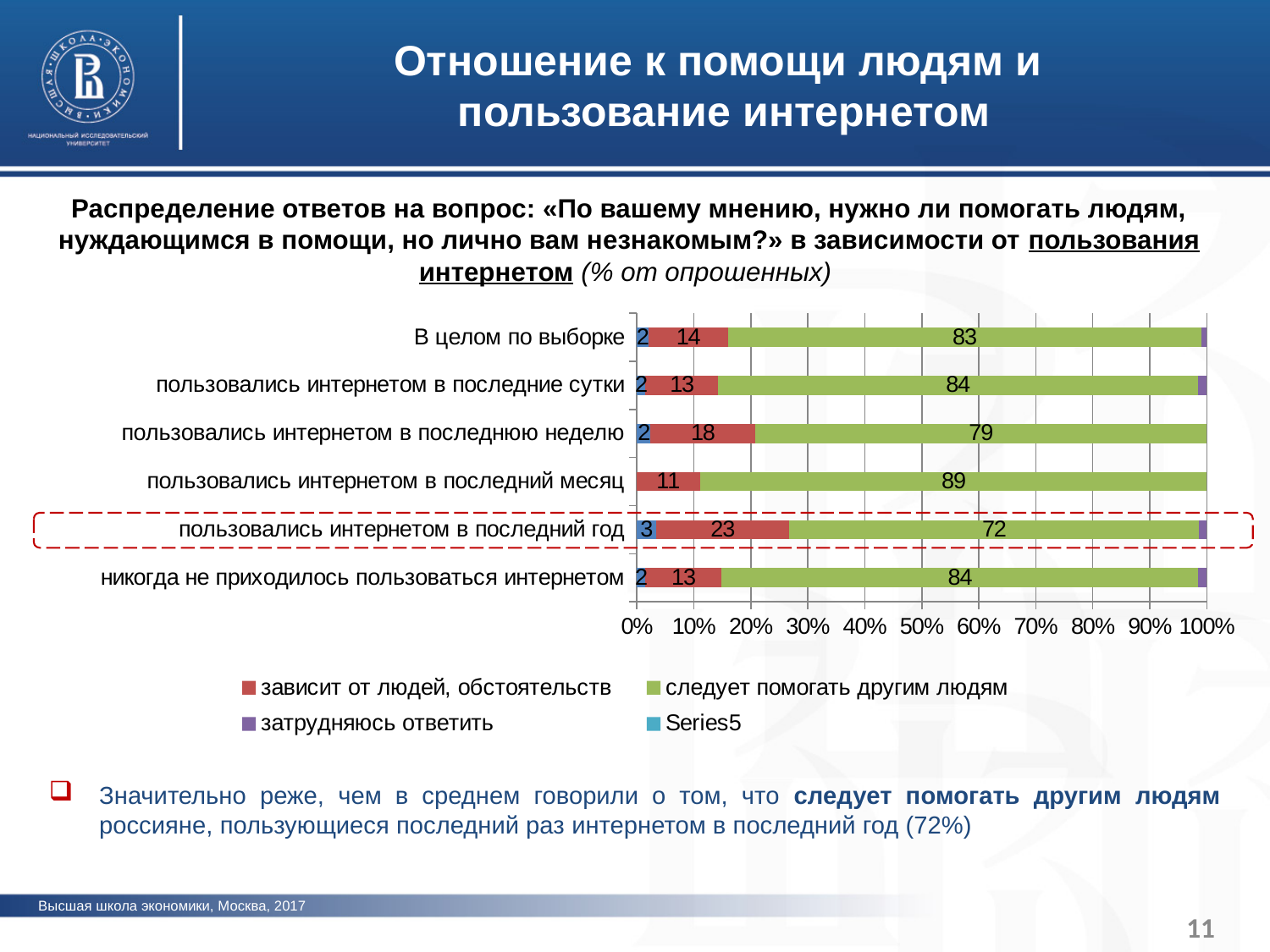
What kind of chart is shown on the slide? stacked bar chart Which category has the lowest value for "следует помогать другим людям"? пользовались интернетом в последний год What is the value of "следует помогать другим людям" for "пользовались интернетом в последний год"? 72 What is the value of "зависит от людей, обстоятельств" for "пользовались интернетом в последнюю неделю"? 18 What is the difference between the "следует помогать другим людям" values for "пользовались интернетом в последний месяц" and "пользовались интернетом в последний год"? 17 Which category on the chart is highlighted with a dashed red outline? пользовались интернетом в последний год Which category has the highest value for "зависит от людей, обстоятельств"? пользовались интернетом в последний год What is the value of "следует помогать другим людям" for "В целом по выборке"? 83 How many series does the legend list? 4 Which is larger: the "зависит от людей, обстоятельств" value for "В целом по выборке" or for "пользовались интернетом в последний месяц"? В целом по выборке Which category has the highest value for "следует помогать другим людям"? пользовались интернетом в последний месяц How many categories are plotted on the chart? 6